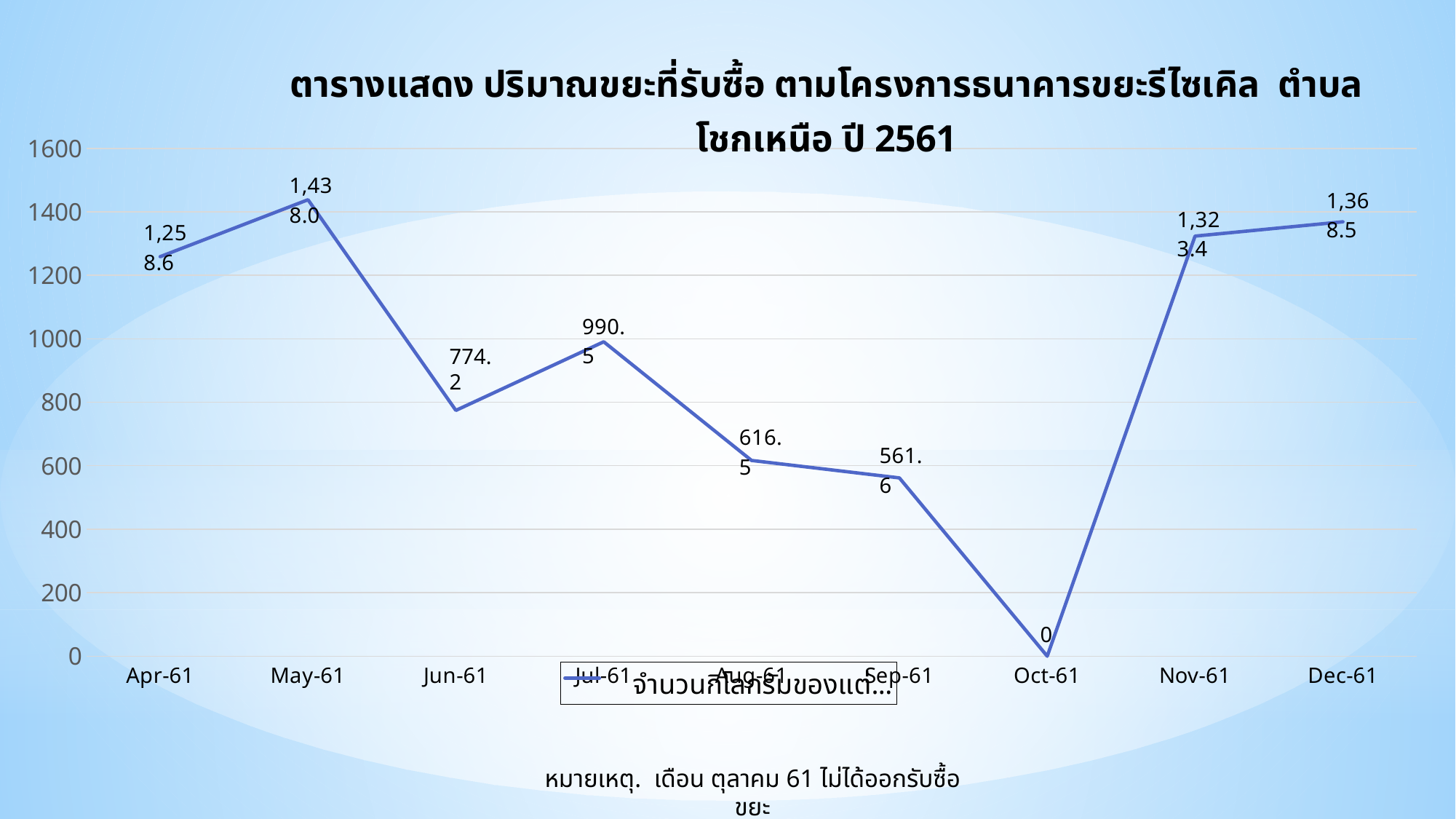
What is the value plotted for Oct-61? 0 Do the values rise or fall from Jul-61 to Oct-61? fall Is the value for Nov-61 greater or less than 1200? greater What kind of chart is shown on the slide? line chart What is the value plotted for Sep-61? 561.6 Which is larger, the value for Apr-61 or the value for Dec-61? Dec-61 How many series does the legend list? 1 How many months (data points) are plotted on the chart? 9 Which month has the highest value on the chart? May-61 What is the value plotted for Jun-61? 774.2 Which month has the lowest value on the chart? Oct-61 Is the value for Jun-61 greater or less than 800? less